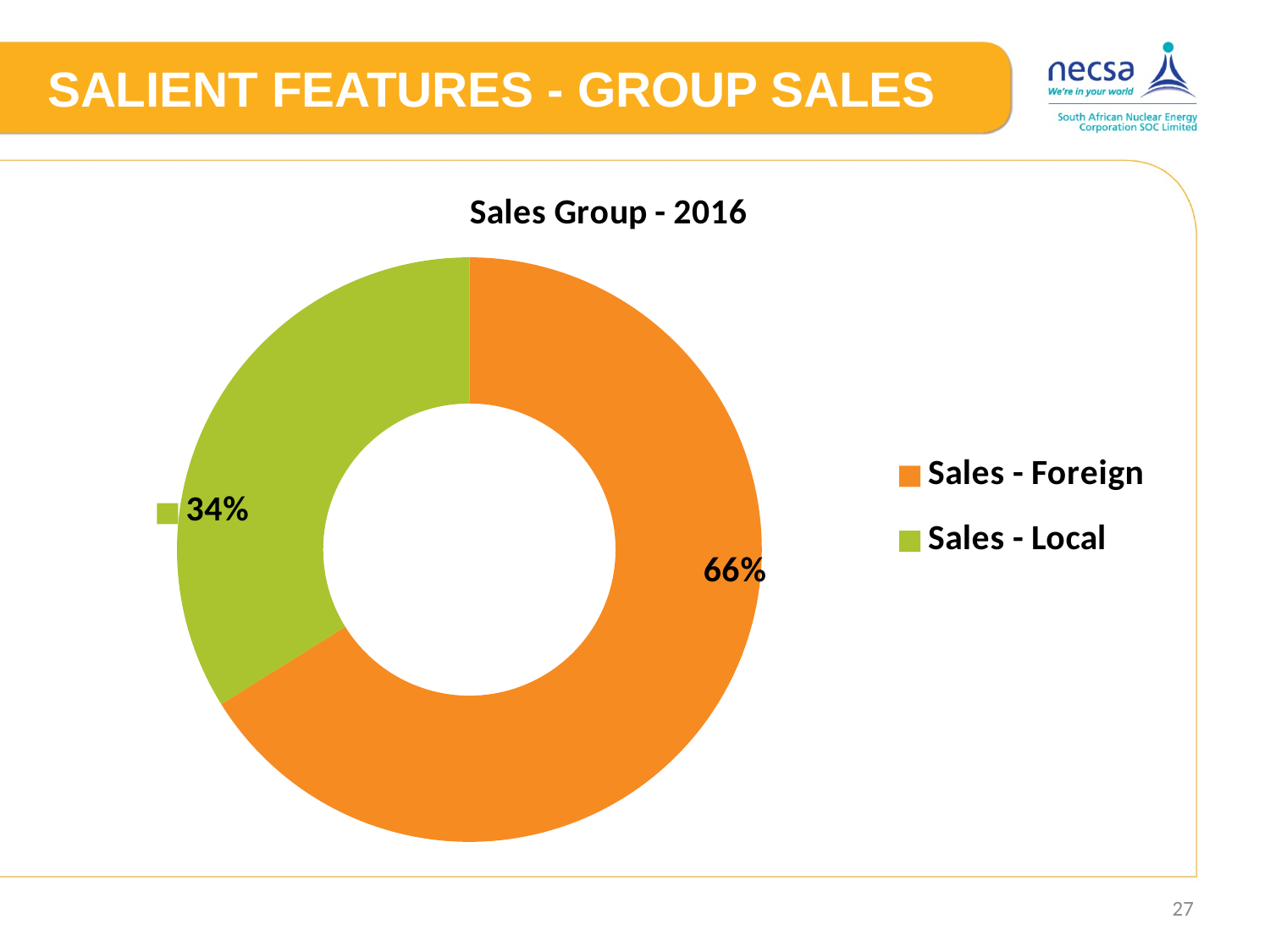
What share of sales does Sales - Local account for? 34% Which category has the largest share of the chart? Sales - Foreign What kind of chart is shown on the slide? Doughnut chart Which category has the smallest share of the chart? Sales - Local What share of sales does Sales - Foreign account for? 66% What is the title of the chart? Sales Group - 2016 Which is larger, Sales - Foreign or Sales - Local? Sales - Foreign How many categories are shown in the chart? 2 Is the share for Sales - Foreign greater or less than 50%? greater What colour represents Sales - Local in the chart? Green What is the difference in percentage points between Sales - Foreign and Sales - Local? 32 How many entries does the legend list? 2